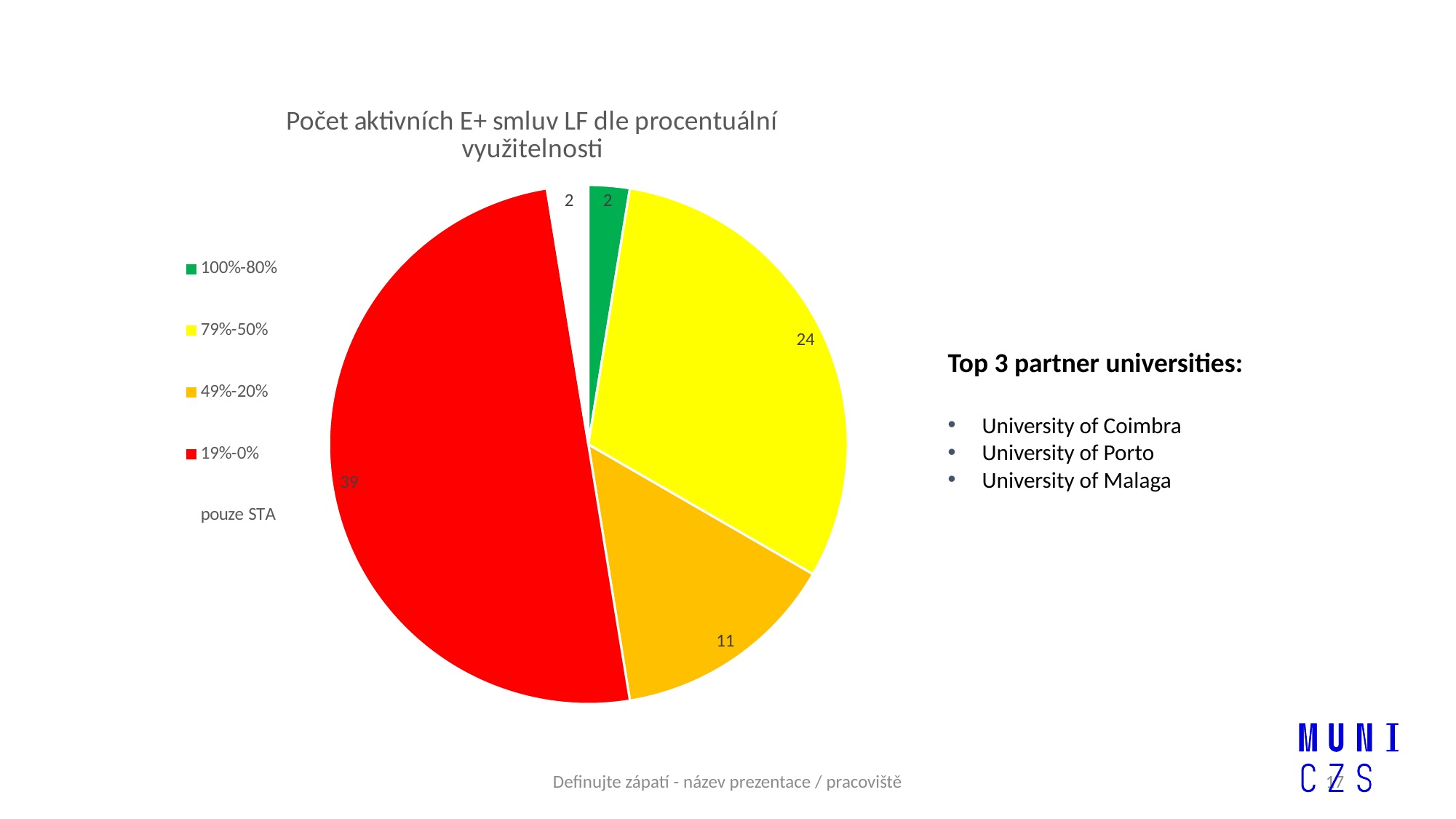
What is the value for the 79%-50% category? 24 What type of chart is shown on the slide? pie chart Which is larger, the value for 79%-50% or the value for 49%-20%? 79%-50% What share of the pie does the 19%-0% slice represent? 50% What is the difference between the values for 19%-0% and 79%-50%? 15 What is the title of the pie chart? Počet aktivních E+ smluv LF dle procentuální využitelnosti Which category has the largest slice of the pie? 19%-0% What is the value for the 100%-80% category? 2 What is the value for the 19%-0% category? 39 How many slices does the pie chart have? 5 What is the value for the 49%-20% category? 11 What is the total of all the values shown in the pie chart? 78